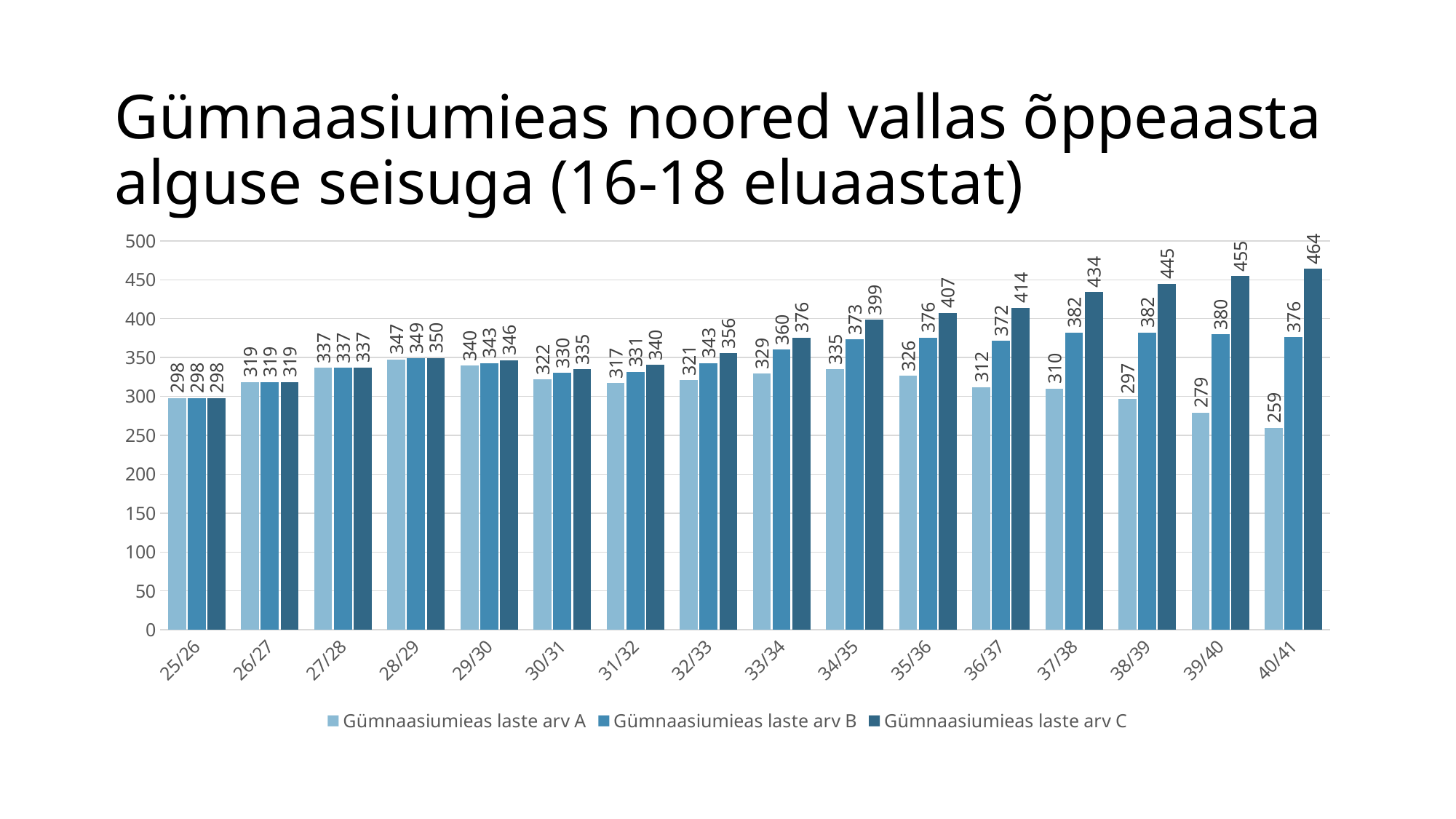
Which school year has the lowest value for Gümnaasiumieas laste arv A? 40/41 What is the value of Gümnaasiumieas laste arv C for 40/41? 464 Which school year has the highest value for Gümnaasiumieas laste arv C? 40/41 What is the value of Gümnaasiumieas laste arv A for 39/40? 279 What is the value of Gümnaasiumieas laste arv B for 33/34? 360 Does Gümnaasiumieas laste arv C rise or fall from 32/33 to 40/41? Rise How many series does the legend list? 3 What is the title of the slide? Gümnaasiumieas noored vallas õppeaasta alguse seisuga (16-18 eluaastat) How many school years are shown on the x axis? 16 What kind of chart is shown on the slide? Bar chart What is the difference between Gümnaasiumieas laste arv C and Gümnaasiumieas laste arv A for 40/41? 205 Which is larger for 36/37: Gümnaasiumieas laste arv B or Gümnaasiumieas laste arv C? Gümnaasiumieas laste arv C